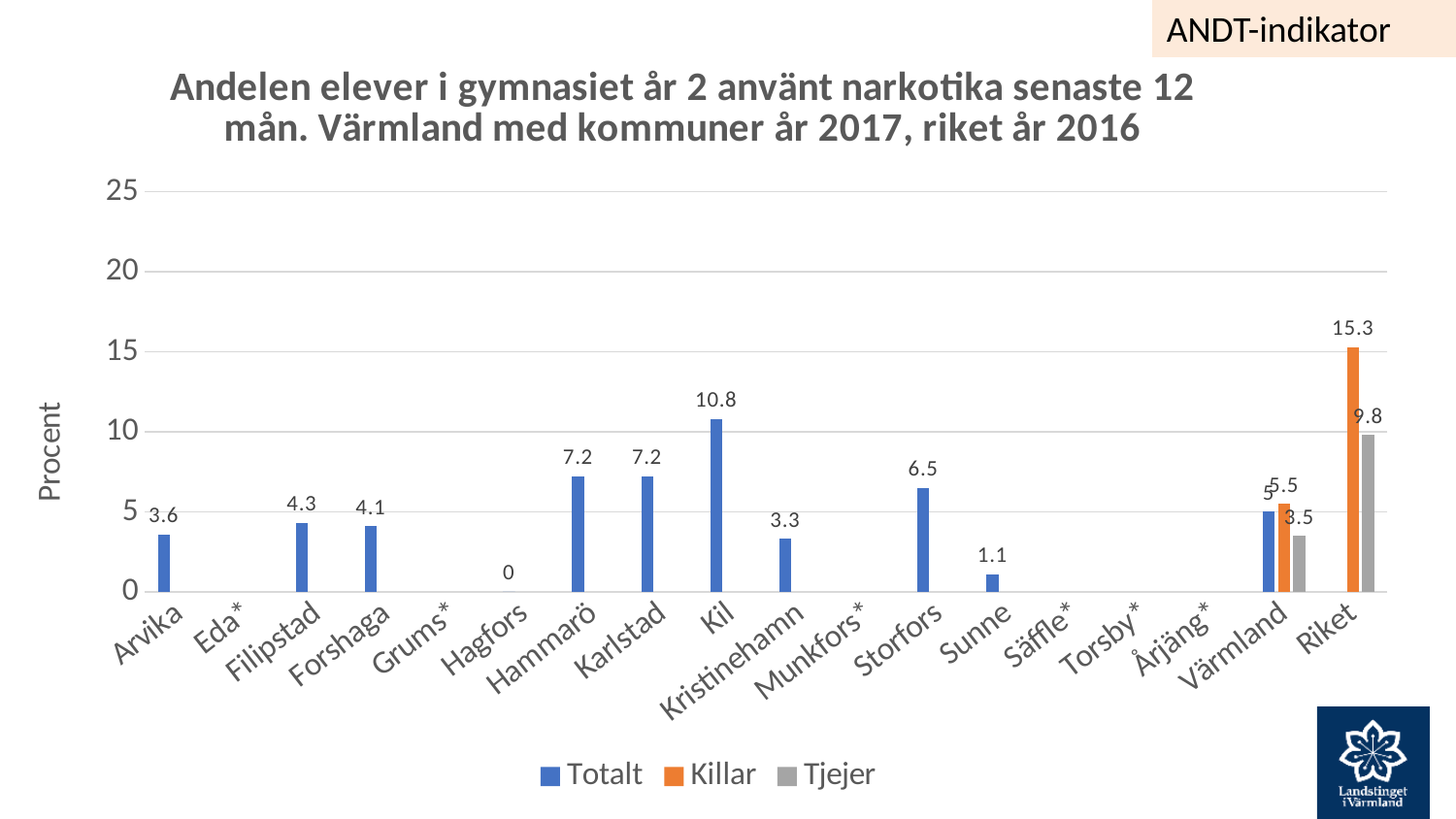
What is the label on the vertical axis? Procent What is the difference between the Totalt values for Kil and Storfors? 4.3 What is the Tjejer value for Riket? 9.8 Which has the larger Totalt value, Filipstad or Forshaga? Filipstad Which category has the lowest labelled Totalt value? Hagfors What is the Totalt value for Kil? 10.8 How many series does the legend list? 3 What is the difference between the Killar and Tjejer values for Riket? 5.5 What kind of chart is shown on the slide? Bar chart What is the Totalt value for Storfors? 6.5 What is the Killar value for Riket? 15.3 Which municipality has the highest Totalt value? Kil